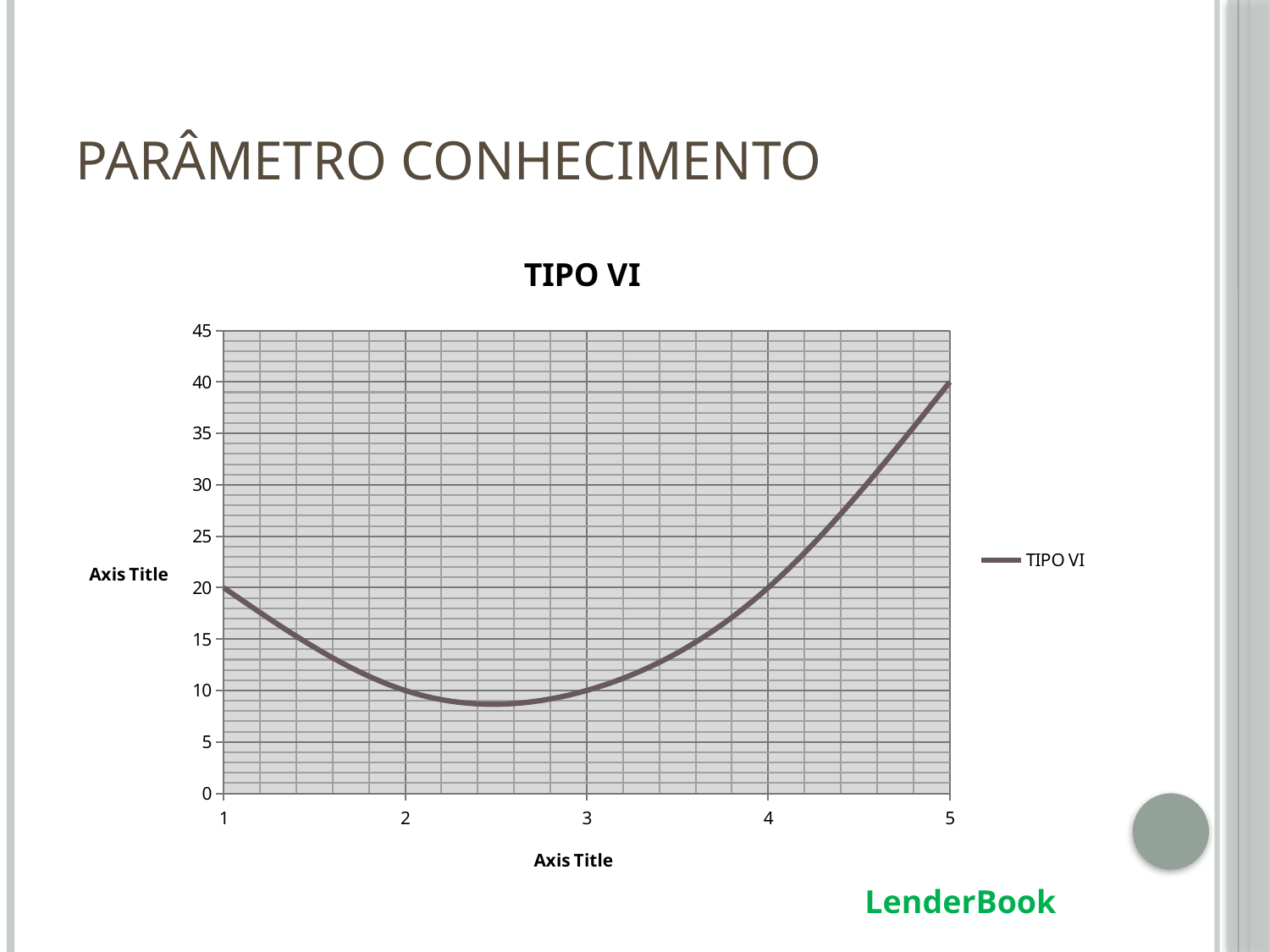
What is the difference between the value at x = 5 and the value at x = 1? 20 What is the title of the chart? TIPO VI How many series does the legend list? 1 What type of chart is shown on the slide? line chart What is the value of TIPO VI at x = 5? 40 Which is larger, the value at x = 5 or the value at x = 1? x = 5 What is the value of TIPO VI at x = 1? 20 How many points are plotted along the x axis? 5 Is the value of TIPO VI at x = 5 greater or less than 35? greater What is the value of TIPO VI at x = 4? 20 Is the value of TIPO VI at x = 2 greater or less than 15? less At which x value is TIPO VI highest? 5